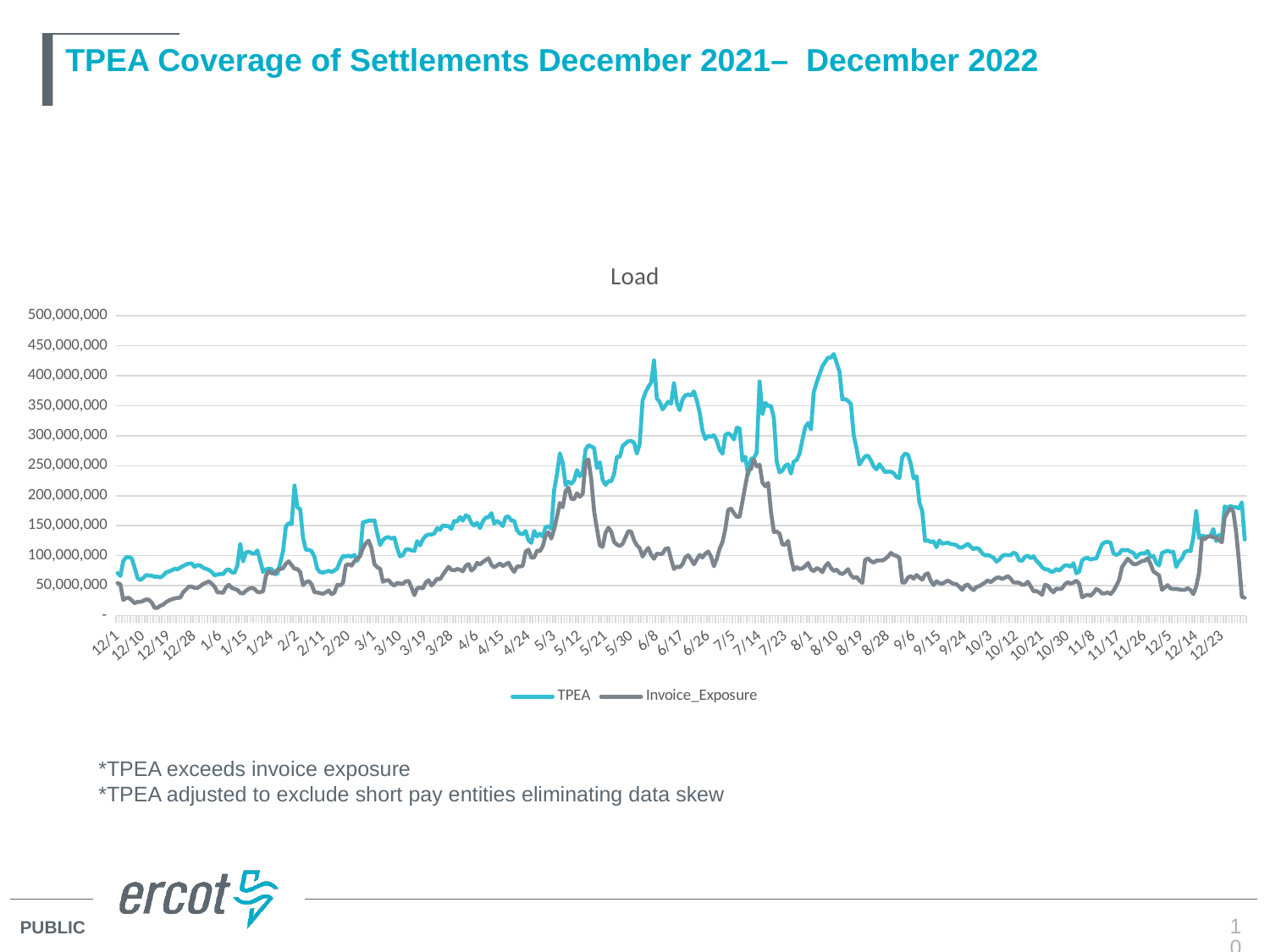
Does the TPEA line rise or fall between 5/21 and 6/8? rise Does the TPEA line rise or fall between 8/10 and 9/15? fall How many series does the legend list? 2 Is the peak value of the TPEA line in August greater or less than 400,000,000? greater Is the Invoice_Exposure value around 12/19 greater or less than 50,000,000? less Which series reaches the highest value anywhere on the chart, TPEA or Invoice_Exposure? TPEA What kind of chart is shown on the slide? line chart Around 8/10, which series has the larger value, TPEA or Invoice_Exposure? TPEA What is the title of the chart? Load Which two series are listed in the chart legend? TPEA and Invoice_Exposure Is the peak value of the Invoice_Exposure line around 5/12 greater or less than 200,000,000? greater